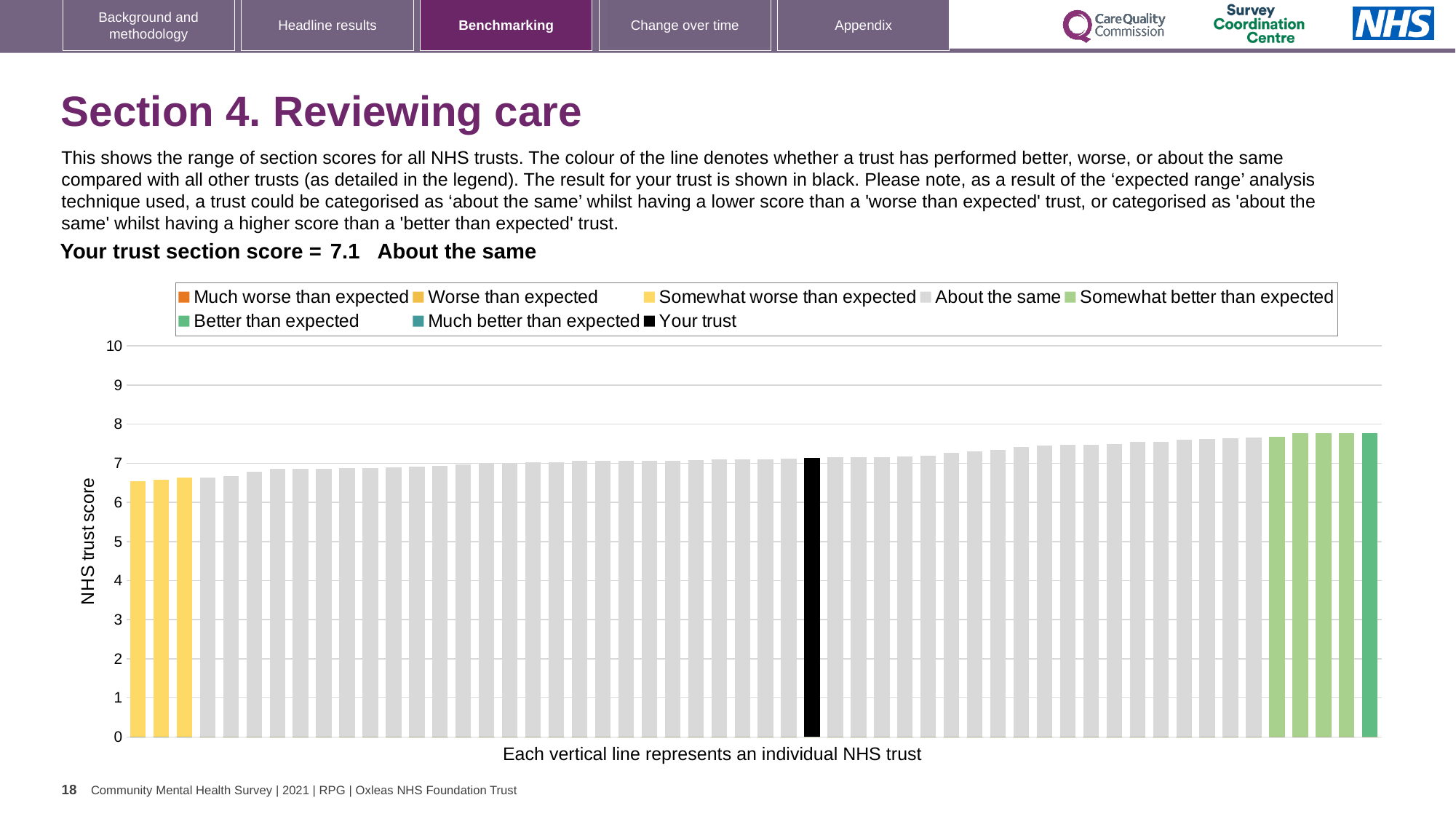
How many entries does the chart legend list? 8 Is the value of the highest bar in the chart greater or less than 7? greater Which is larger: the value for your trust (black bar) or the value of the leftmost bar? your trust Is the value for your trust (the black bar) greater or less than 5? greater What colour is the bar representing your trust? black Is the value of the lowest bar in the chart greater or less than 7? less What is the label on the vertical axis of the chart? NHS trust score Do the bar values rise or fall from left to right along the x axis? rise What is the section score for your trust shown on the slide? 7.1 What kind of chart is shown on the slide? bar chart